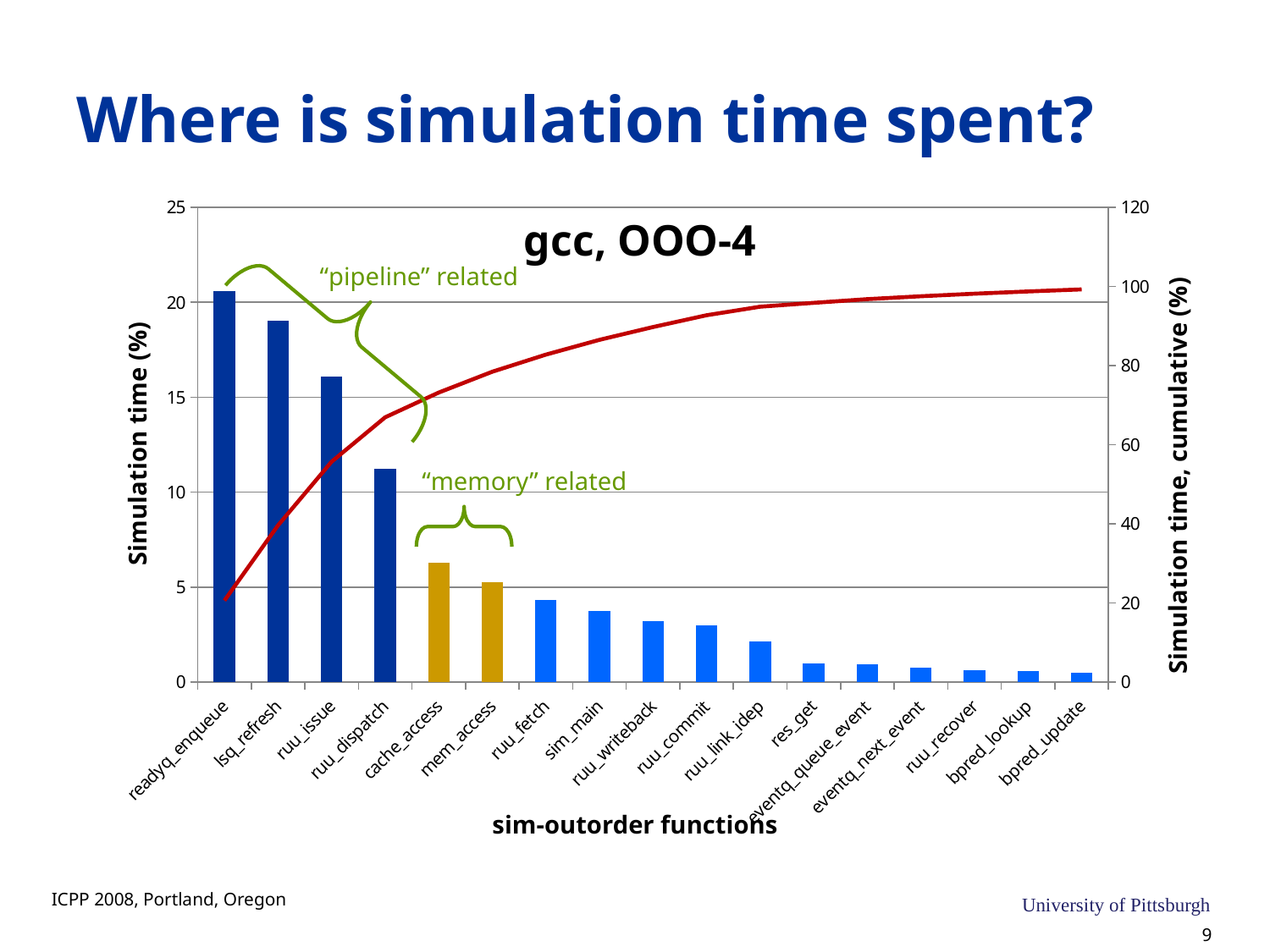
What is the title shown inside the chart area? gcc, OOO-4 What kind of chart is shown on the slide? bar and line chart Is the simulation time for ruu_issue greater or less than 15? greater Is the simulation time for ruu_dispatch greater or less than 10? greater Which function has the highest simulation time? readyq_enqueue Which has a larger simulation time, readyq_enqueue or lsq_refresh? readyq_enqueue Do the bar values rise or fall moving left to right along the x axis? fall Is the simulation time for ruu_fetch greater or less than 5? less How many functions (categories) are plotted along the x axis? 17 Which has a larger simulation time, ruu_dispatch or cache_access? ruu_dispatch